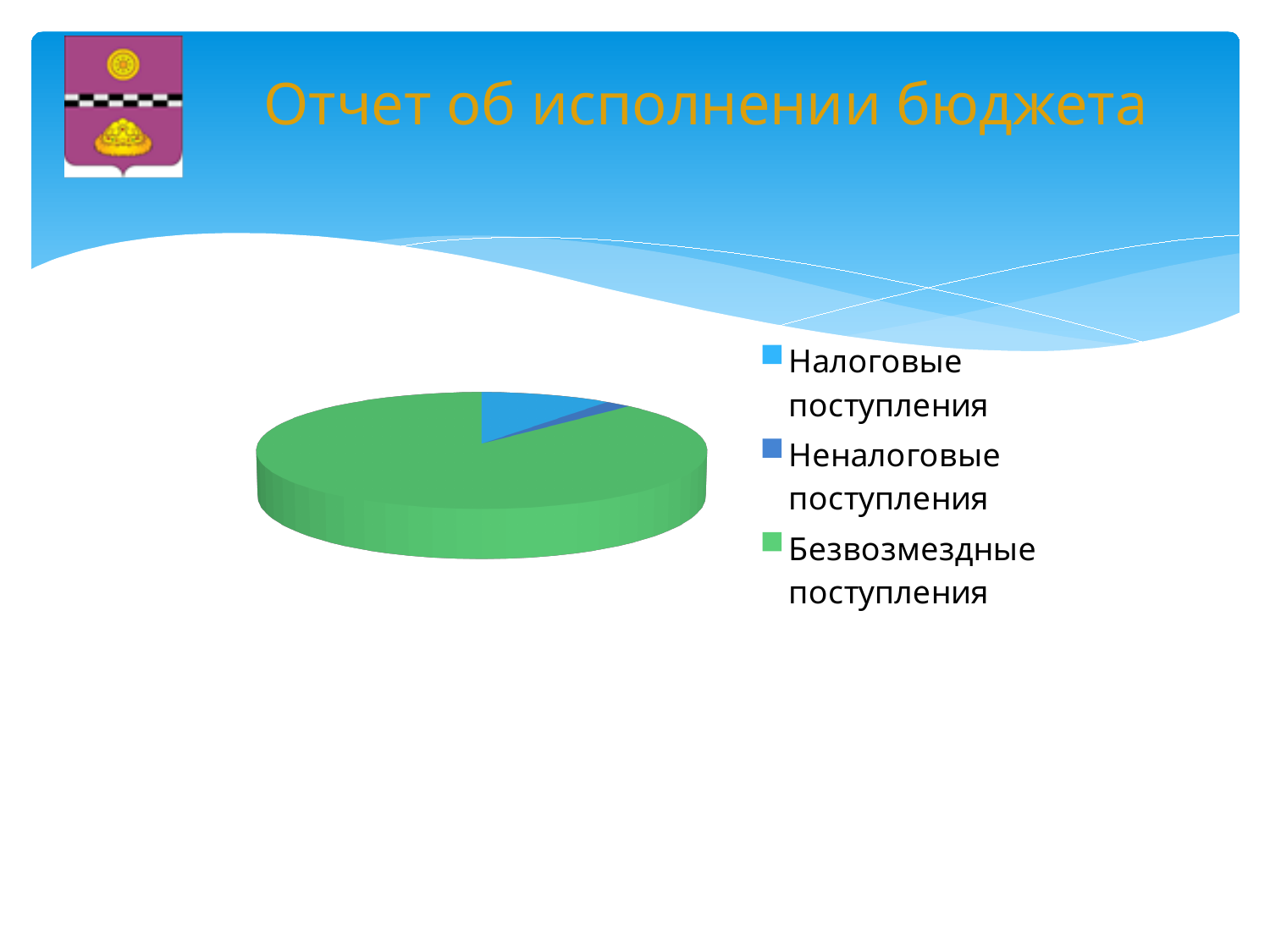
What colour is the slice for Безвозмездные поступления in the pie chart? Green Which category has the largest slice of the pie chart? Безвозмездные поступления Which slice is larger: Налоговые поступления or Безвозмездные поступления? Безвозмездные поступления What is the title of the slide containing the pie chart? Отчет об исполнении бюджета What kind of chart is shown on the slide? Pie chart How many entries does the legend of the pie chart list? 3 Which slice is larger: Налоговые поступления or Неналоговые поступления? Налоговые поступления Which category has the smallest slice of the pie chart? Неналоговые поступления How many categories does the pie chart show? 3